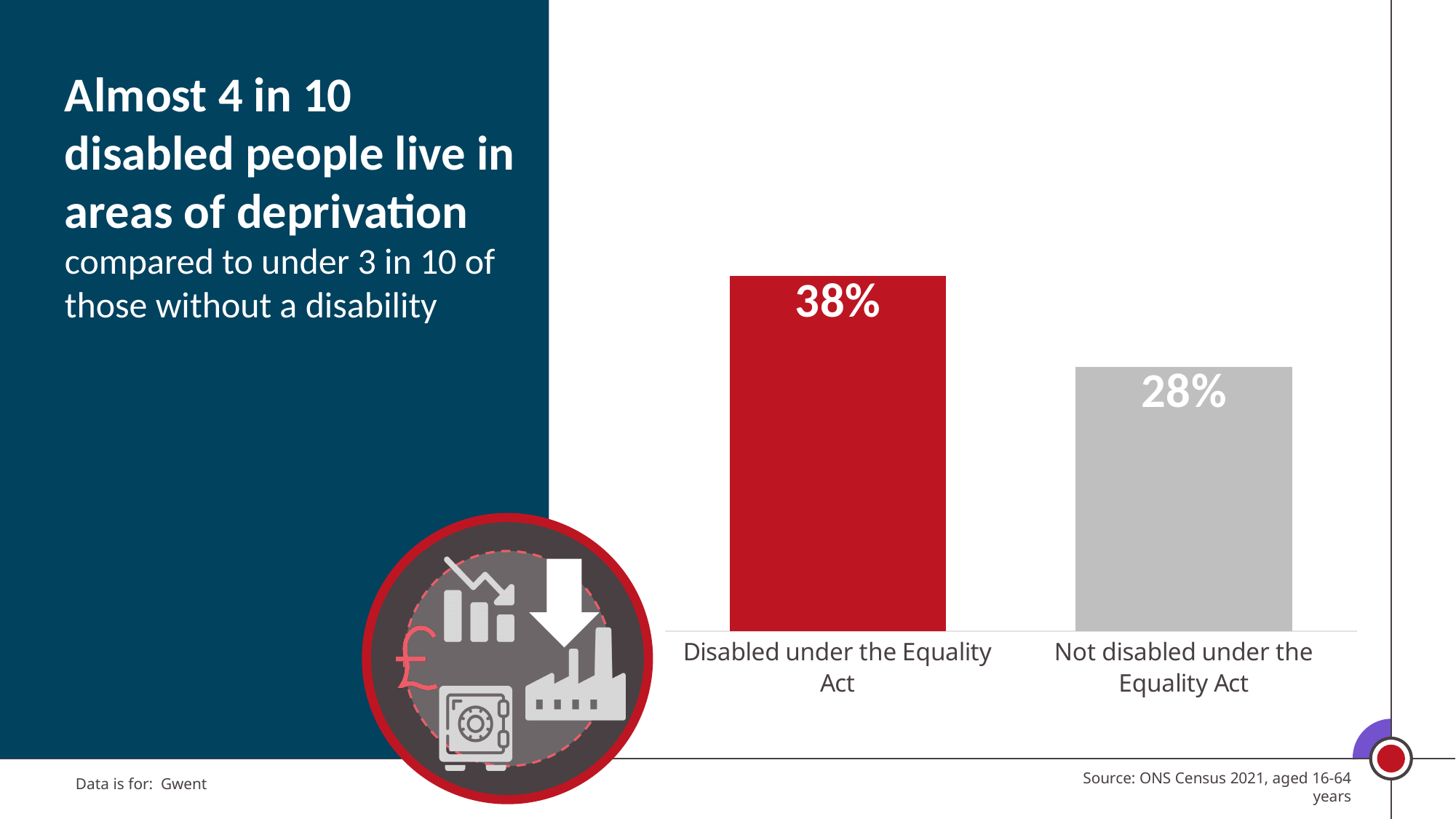
How many categories are shown in the chart? 2 What colour is the bar for Disabled under the Equality Act? Red What kind of chart is shown on the slide? Bar chart Which category has the lowest value? Not disabled under the Equality Act Do the values rise or fall from left to right across the categories? Fall What is the value for Not disabled under the Equality Act? 28% What area is the data for, according to the slide? Gwent What is the difference between the values for Disabled under the Equality Act and Not disabled under the Equality Act? 10% What is the value for Disabled under the Equality Act? 38% Which category has the highest value? Disabled under the Equality Act Which is larger: the value for Disabled under the Equality Act or Not disabled under the Equality Act? Disabled under the Equality Act